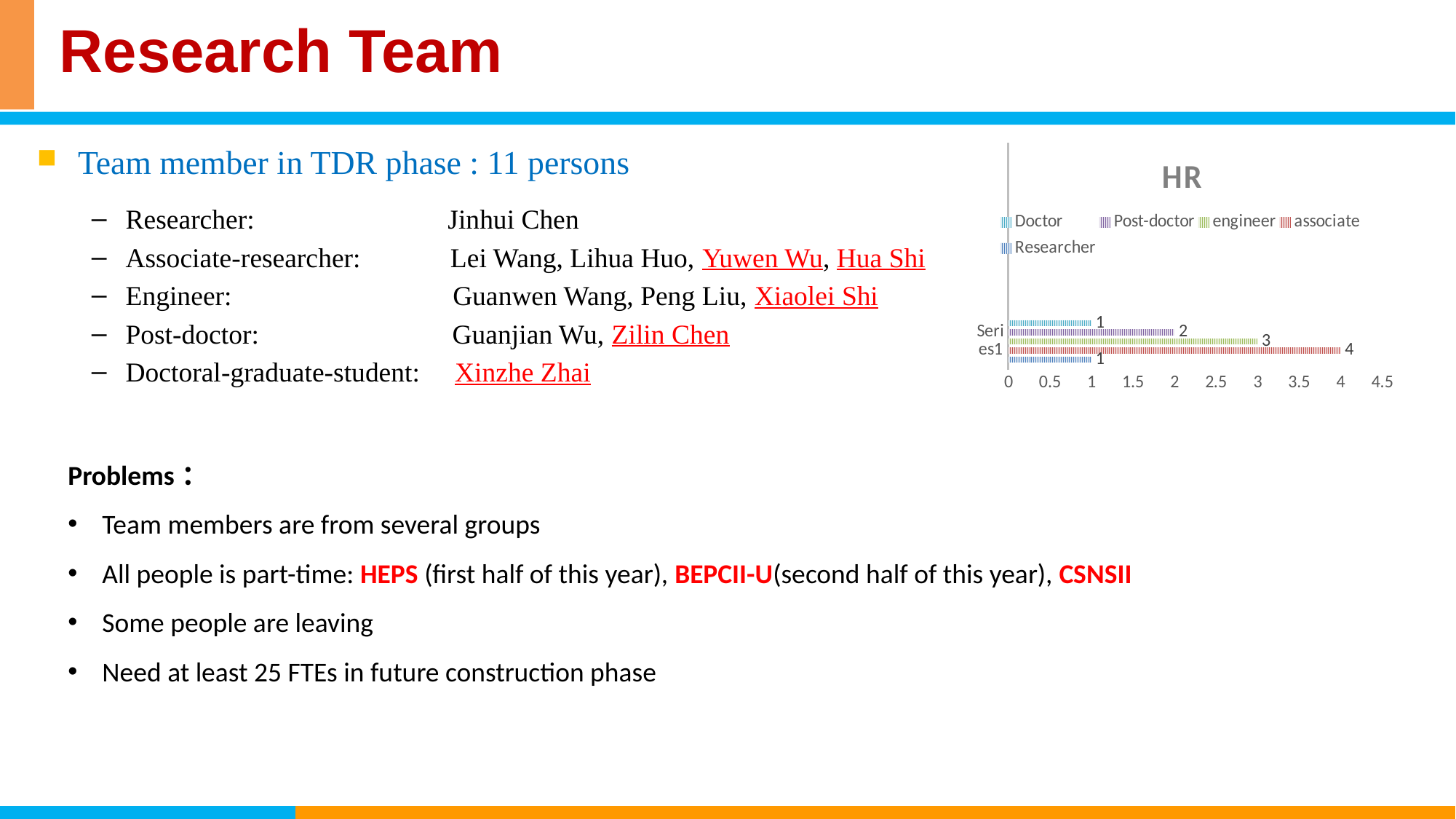
Is the value for associate greater or less than 3.5? greater What kind of chart is shown on the slide? bar chart What is the difference between the associate value and the Post-doctor value? 2 Which is larger, the engineer value or the Doctor value? engineer What is the value for the engineer series in the HR chart? 3 What is the value for the associate series in the HR chart? 4 How many series does the chart legend list? 5 Which series has the highest value in the HR chart? associate What is the title of the chart? HR What is the maximum value shown on the horizontal axis of the HR chart? 4.5 What is the value for the Post-doctor series in the HR chart? 2 What is the value for the Doctor series in the HR chart? 1